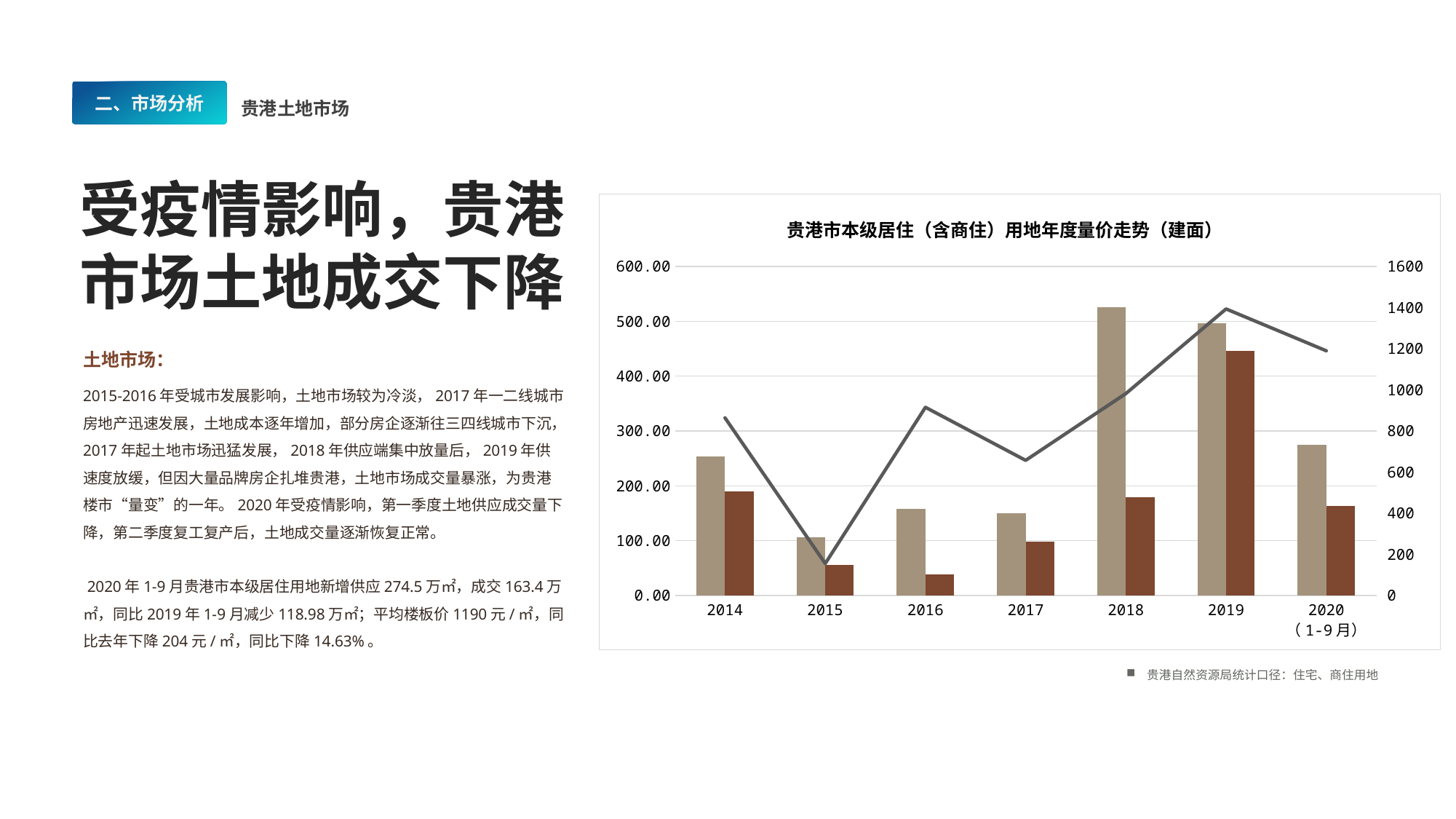
Does the line rise or fall from 2017 to 2019? rises How many year categories are shown on the x axis of the chart? 7 In which year is the brown (darker) bar the shortest? 2016 Is the line value for 2015 greater or less than 200 on the right axis? less In which year is the brown (darker) bar the tallest? 2019 In which year is the tan (lighter) bar the tallest? 2018 What is the title of the chart? 贵港市本级居住（含商住）用地年度量价走势（建面） Is the brown bar for 2016 greater or less than 100.00 on the left axis? less In which year is the tan (lighter) bar the shortest? 2015 Which is larger, the brown bar for 2017 or the brown bar for 2018? 2018 Is the tan bar for 2018 greater or less than 500.00 on the left axis? greater What kind of chart is shown on the slide? A combined bar and line chart